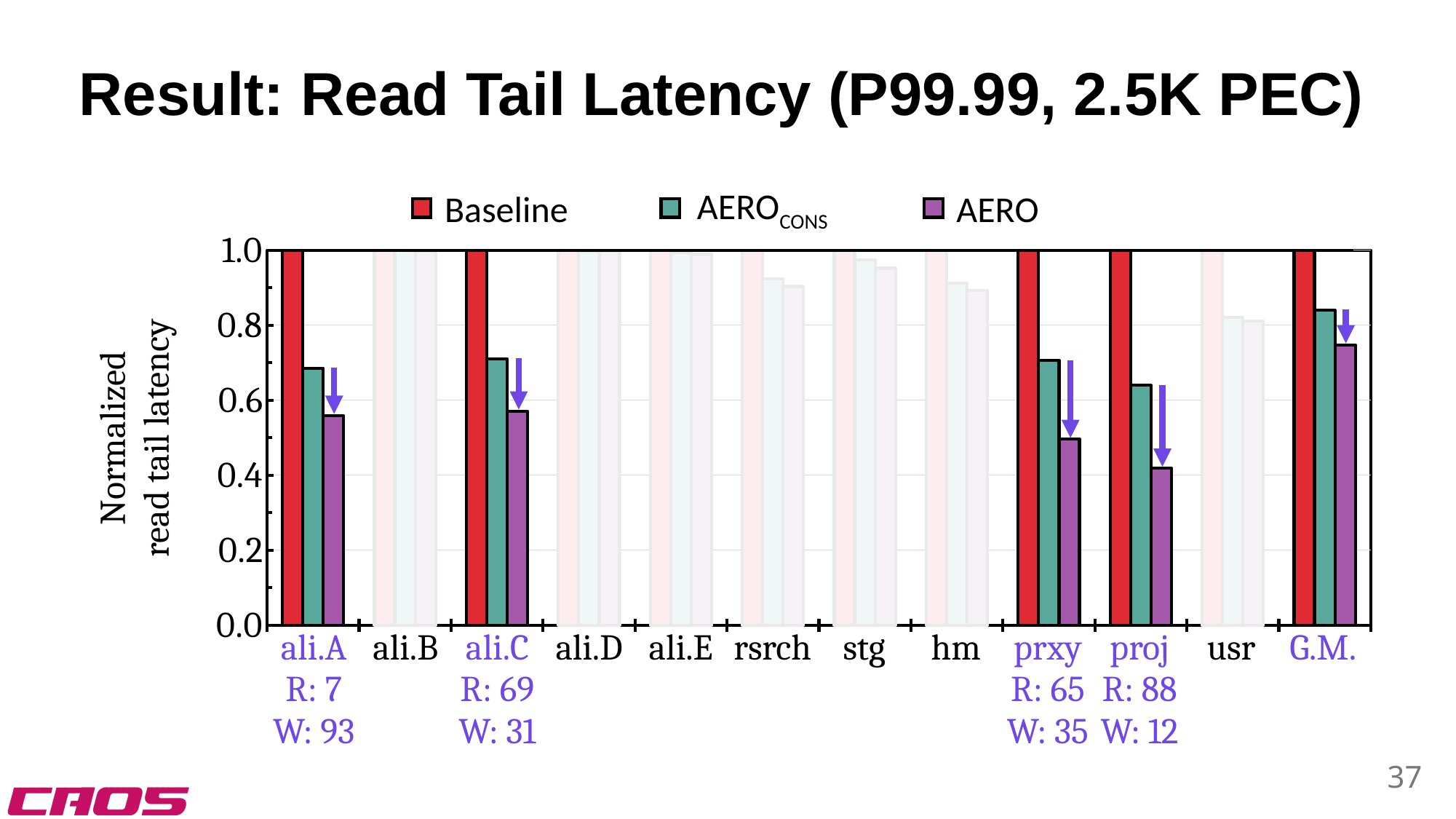
Is the AERO value for proj greater or less than 0.6? less Is the AERO value for ali.A greater or less than 0.6? less For proj, which is larger: the AERO_CONS value or the AERO value? AERO_CONS What is the normalized read tail latency of Baseline for ali.A? 1.0 How many categories are shown along the x axis? 12 Is the AERO value for G.M. greater or less than 0.8? less What is the label of the y axis? Normalized read tail latency What kind of chart is shown on the slide? bar chart Which category has the lowest AERO value? proj How many series does the legend list? 3